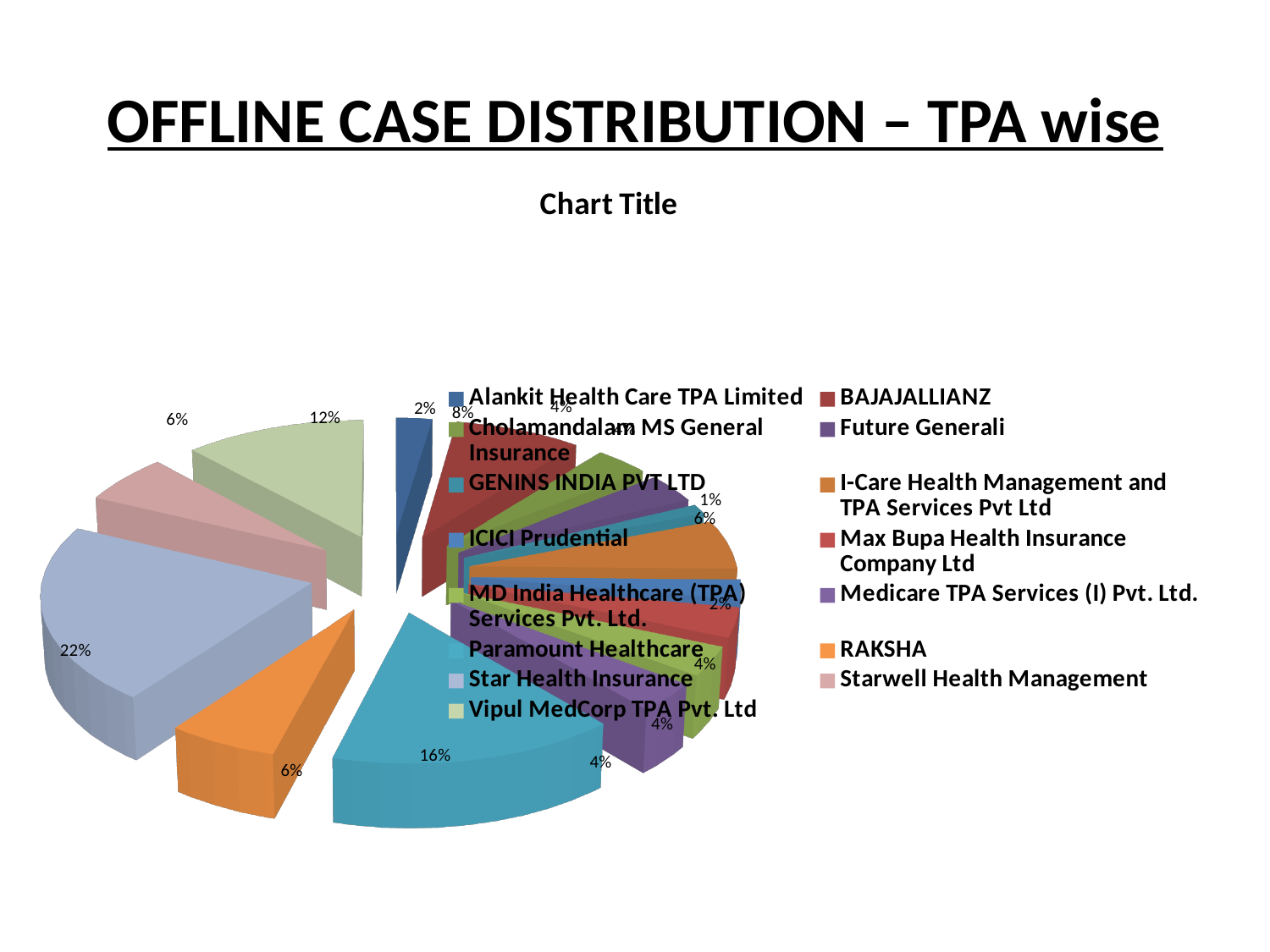
What share of offline cases does BAJAJALLIANZ account for? 8% How many entries does the chart legend list? 15 By how many percentage points does Star Health Insurance's share exceed Vipul MedCorp TPA Pvt. Ltd's share? 10 percentage points What share of offline cases does Vipul MedCorp TPA Pvt. Ltd account for? 12% Which TPA has the smallest slice of the pie? GENINS INDIA PVT LTD Which TPA has the largest slice of the pie? Star Health Insurance Which has the larger share, Star Health Insurance or MD India Healthcare (TPA) Services Pvt. Ltd.? Star Health Insurance What share of offline cases does Star Health Insurance account for? 22% What is the title shown above the chart? Chart Title What kind of chart is shown on the slide? Pie chart